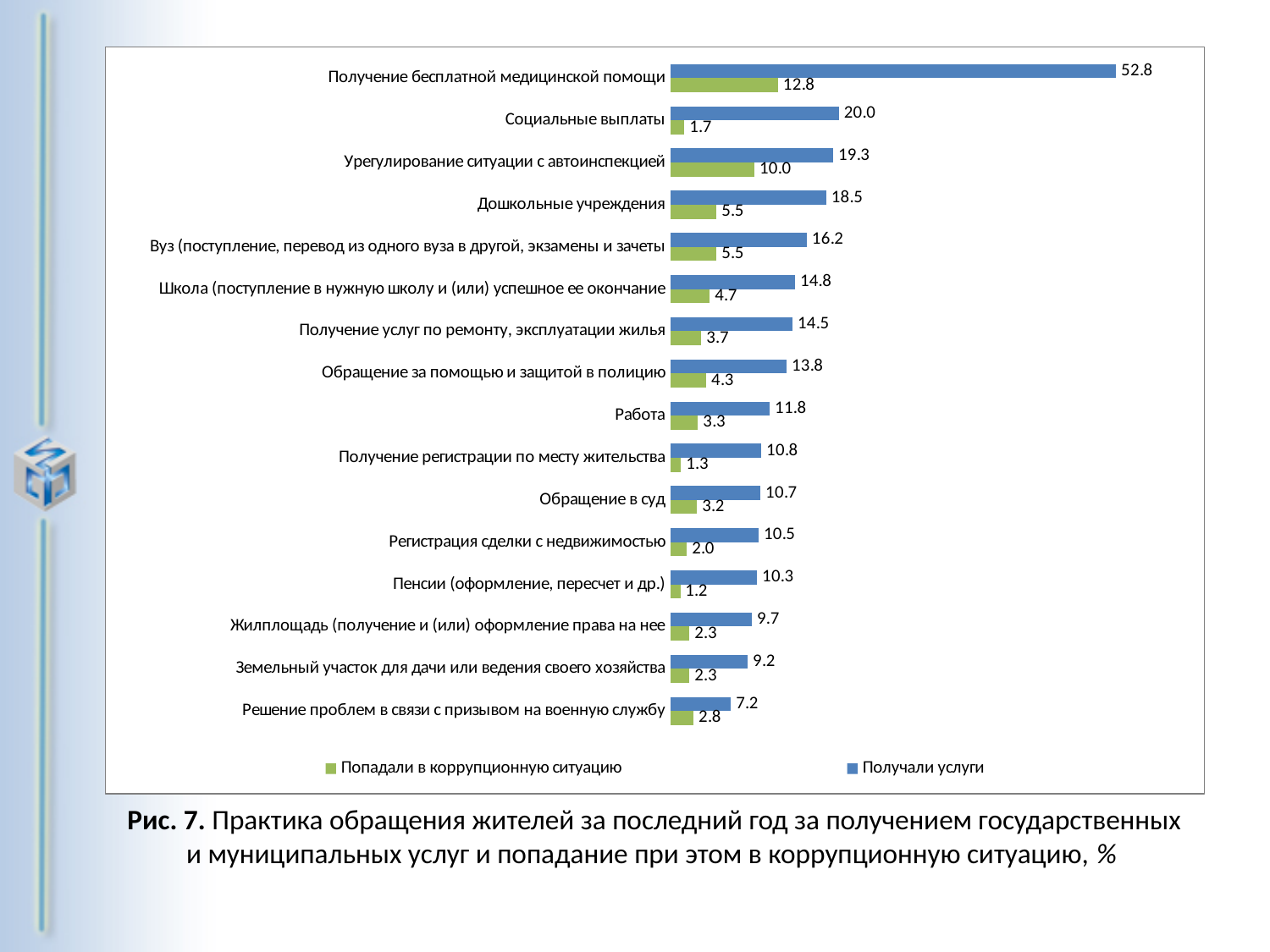
What kind of chart is shown on the slide? Bar chart Which category has the highest value for "Получали услуги"? Получение бесплатной медицинской помощи What is the value of "Попадали в коррупционную ситуацию" for "Урегулирование ситуации с автоинспекцией"? 10.0 What is the value of "Получали услуги" for "Получение бесплатной медицинской помощи"? 52.8 What is the difference between the "Получали услуги" and "Попадали в коррупционную ситуацию" values for "Социальные выплаты"? 18.3 Which is larger: the "Получали услуги" value for "Дошкольные учреждения" or for "Работа"? Дошкольные учреждения How many series does the legend list? 2 What is the value of "Попадали в коррупционную ситуацию" for "Пенсии (оформление, пересчет и др.)"? 1.2 Which colour represents the series "Получали услуги"? Blue Which category has the lowest value for "Получали услуги"? Решение проблем в связи с призывом на военную службу Which category has the lowest value for "Попадали в коррупционную ситуацию"? Пенсии (оформление, пересчет и др.) How many categories are shown in the chart? 16